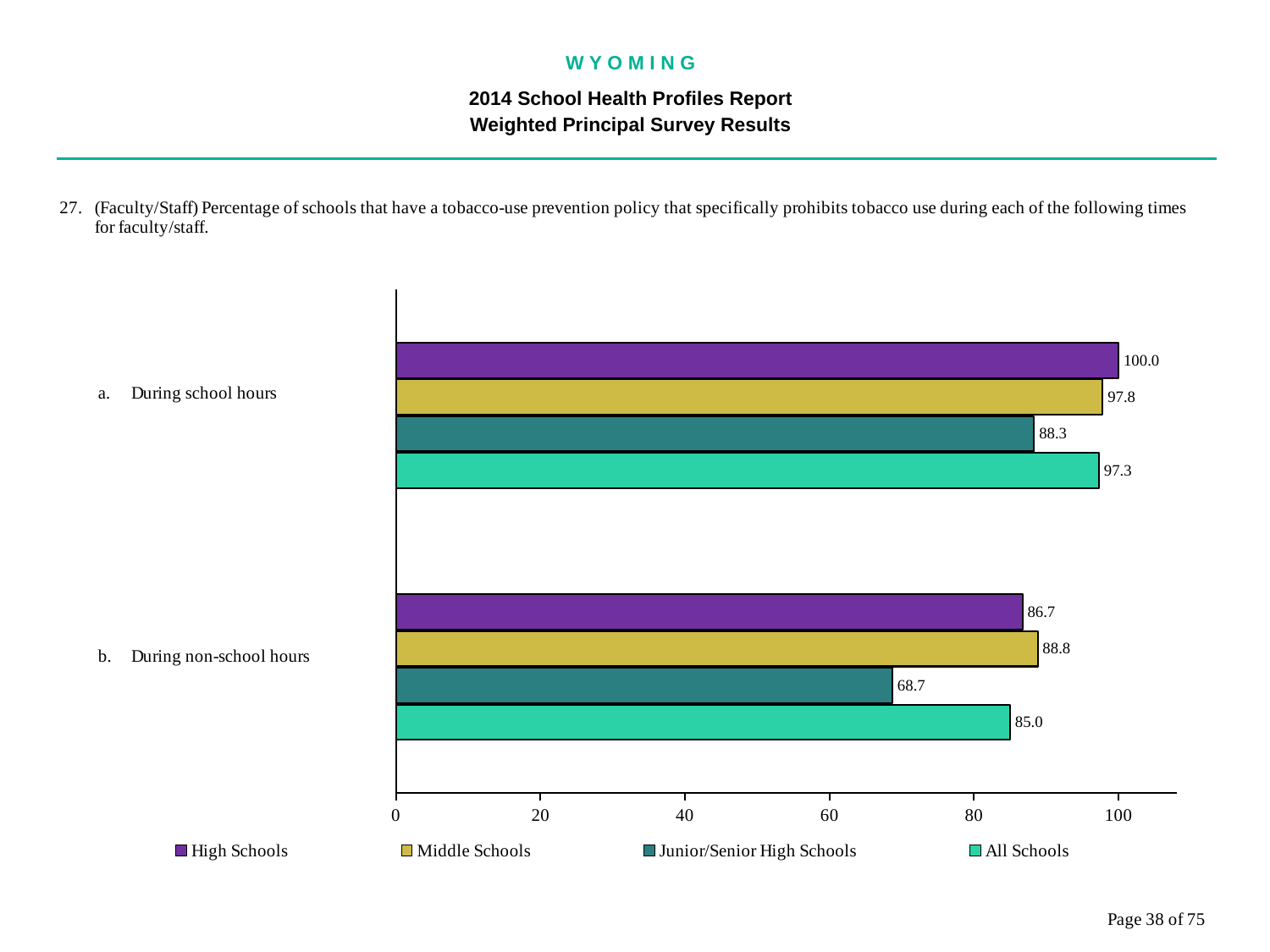
What is the difference between the High Schools values for during school hours and during non-school hours? 13.3 What is the value for Middle Schools during school hours? 97.8 Which school type has the lowest value during school hours? Junior/Senior High Schools What is the value for Junior/Senior High Schools during non-school hours? 68.7 What kind of chart is shown on the slide? Bar chart How many series does the legend list? 4 What is the value for All Schools during non-school hours? 85.0 Which school type has the highest value during non-school hours? Middle Schools Which is larger: the Middle Schools value during non-school hours or the High Schools value during non-school hours? Middle Schools How many categories (time periods) are shown on the chart? 2 What is the value for High Schools during school hours? 100.0 What is the difference between the All Schools values for during school hours and during non-school hours? 12.3